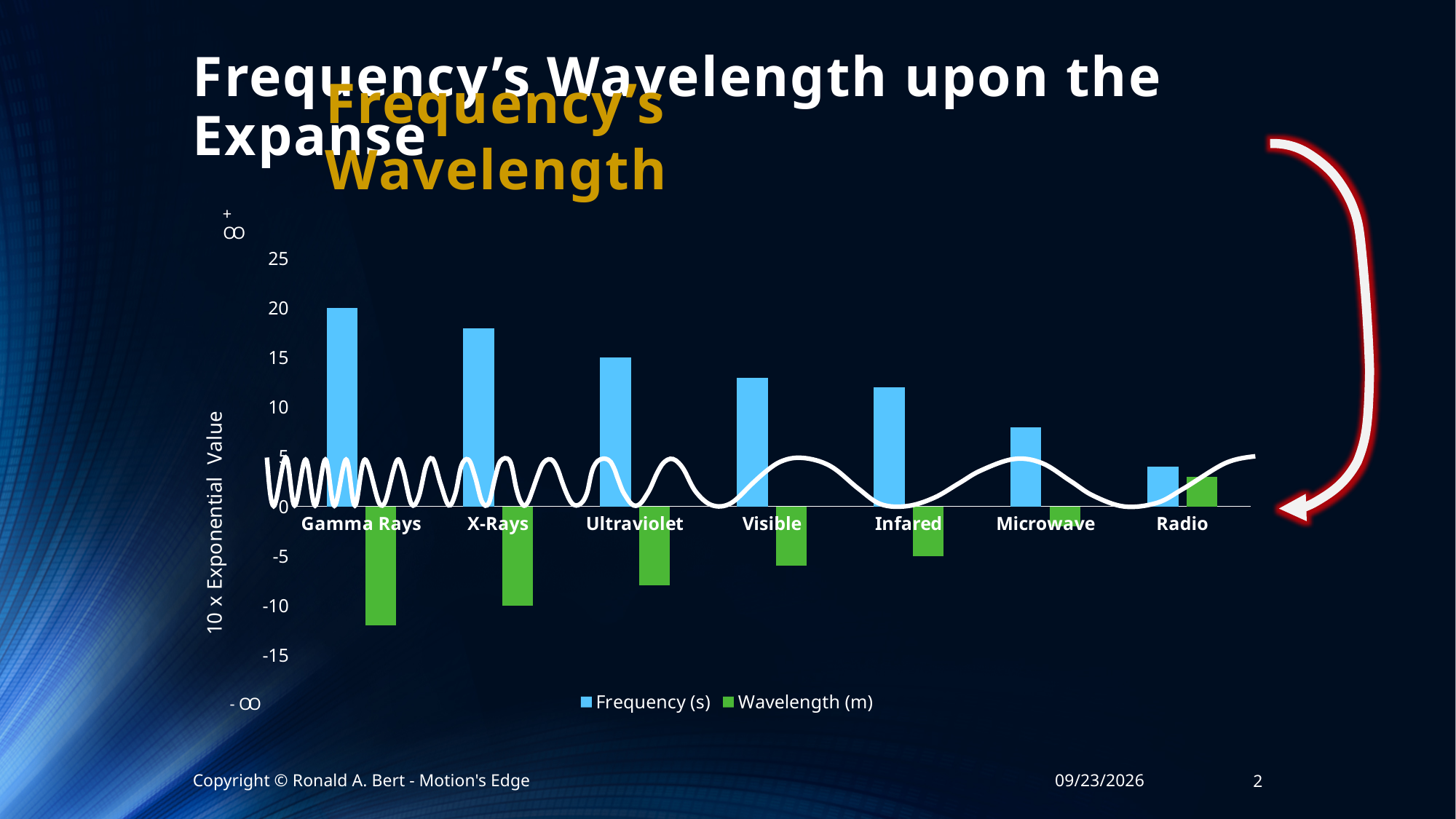
Is the Frequency (s) value for X-Rays greater or less than 15? greater What is the title of the chart's vertical axis? 10 x Exponential Value What kind of chart is shown on the slide? bar chart Do the Frequency (s) values rise or fall moving from Gamma Rays to Radio along the x axis? fall How many categories are shown on the x axis of the chart? 7 Which category has the lowest Frequency (s) value? Radio What is the Frequency (s) value for Gamma Rays? 20 Which category has the highest Frequency (s) value? Gamma Rays Is the Frequency (s) value for Microwave greater or less than 10? less How many series does the chart's legend list? 2 What is the Frequency (s) value for Ultraviolet? 15 Is the Wavelength (m) value for Gamma Rays greater or less than -10? less